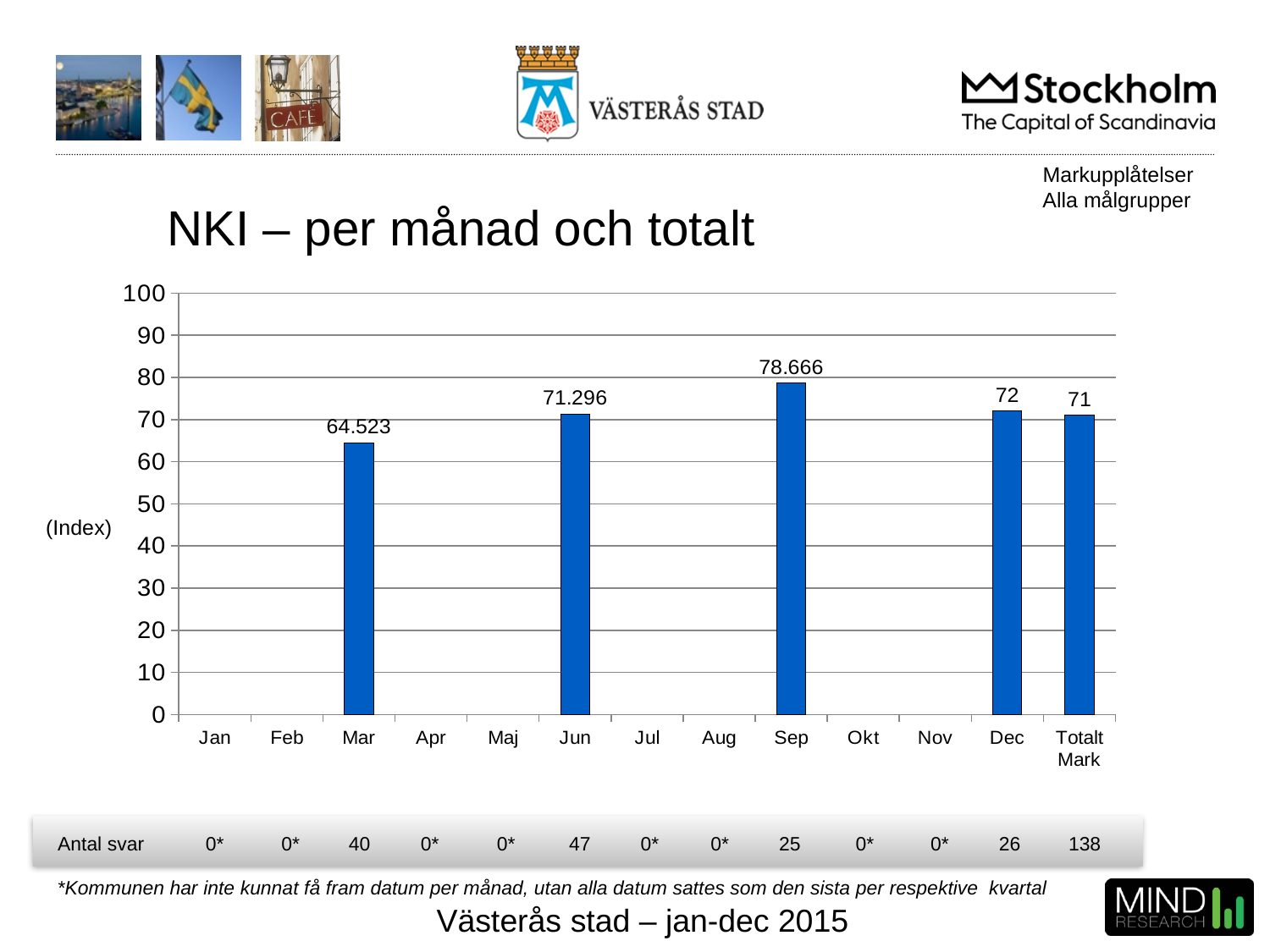
What is the NKI value for Sep? 78.666 What is the NKI value for Jun? 71.296 Is the NKI value for Sep greater or less than 80? less Among the months with a plotted bar, which has the lowest NKI value? Mar Which is larger, the NKI value for Dec or for Jun? Dec What is the difference between the NKI values for Sep and Mar? 14.143 Which month has the highest NKI value? Sep How many categories are shown on the x axis? 13 What kind of chart is shown on the slide? bar chart What is the NKI value for Dec? 72 What is the NKI value for Totalt Mark? 71 What is the NKI value for Mar? 64.523